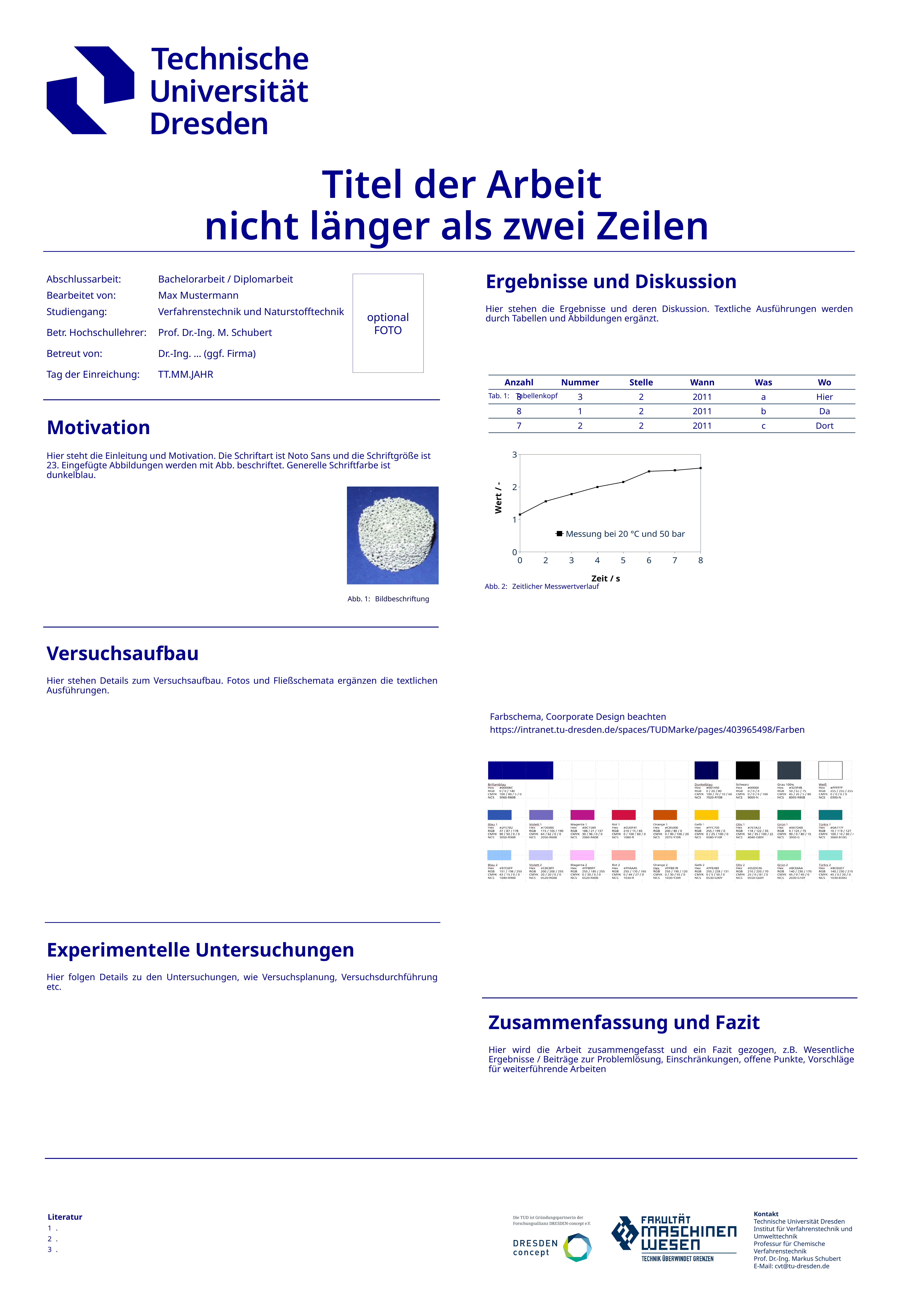
In the chart in Abb. 2, is the value at Zeit = 0 s greater or less than 2? less How many data points are plotted in the chart in Abb. 2? 8 Do the values in the chart in Abb. 2 rise or fall as Zeit / s increases? rise What kind of chart is shown in Abb. 2 (Zeitlicher Messwertverlauf)? line chart How many series does the legend of the chart in Abb. 2 list? 1 At which Zeit / s value is the lowest point in the chart in Abb. 2? 0 What is the title of the y axis of the chart in Abb. 2? Wert / - In the chart in Abb. 2, is the value at Zeit = 0 s greater or less than 1? greater In the chart in Abb. 2, is the value at Zeit = 6 s greater or less than 3? less What is the legend entry of the series plotted in the chart in Abb. 2? Messung bei 20 °C und 50 bar